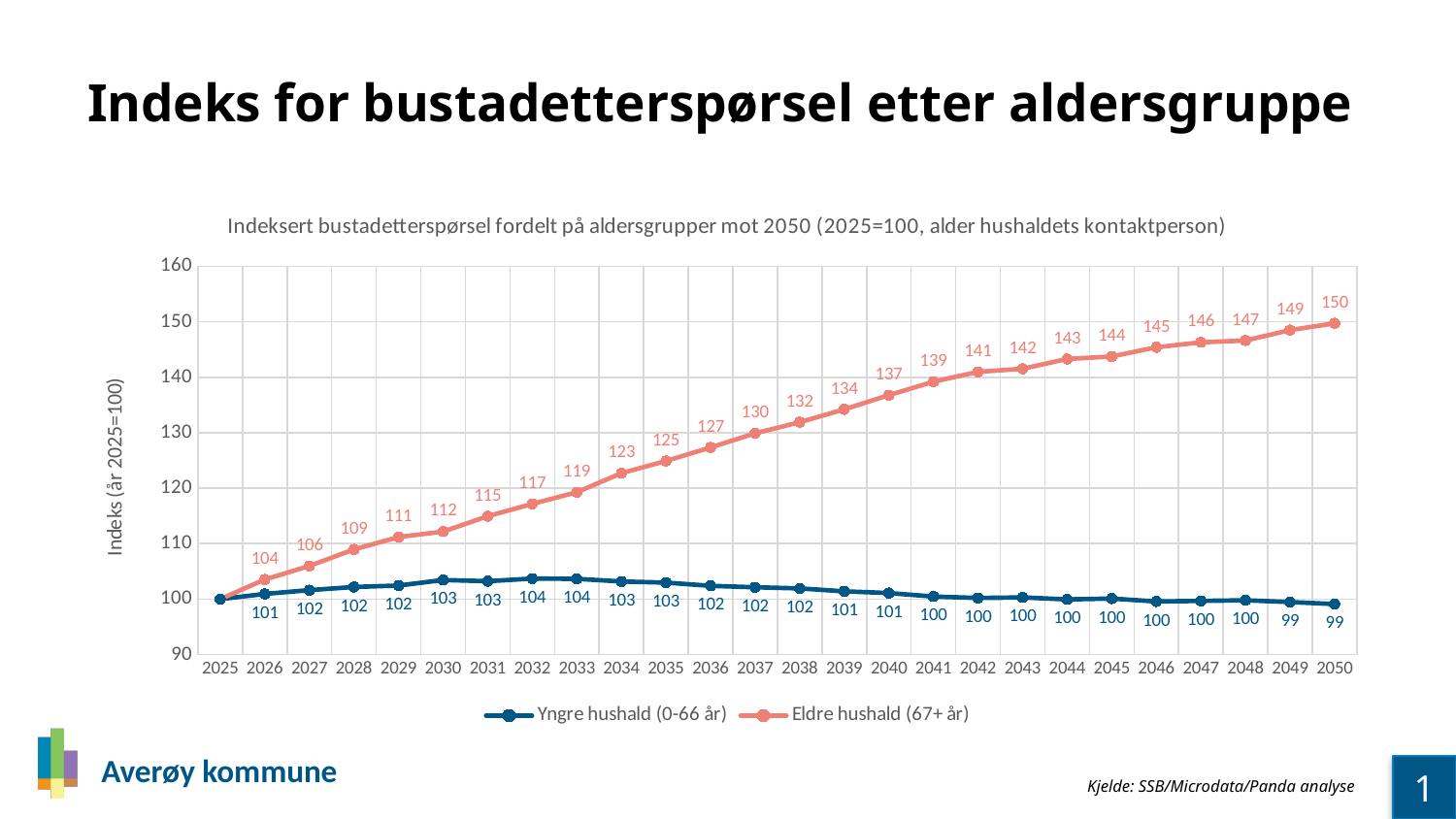
What is the value for Eldre hushald (67+ år) in 2050? 150 What is the value for Eldre hushald (67+ år) in 2040? 137 Does the value for Eldre hushald (67+ år) rise or fall from 2025 to 2050? Rise Which series has the larger value in 2035, Yngre hushald (0-66 år) or Eldre hushald (67+ år)? Eldre hushald (67+ år) What is the label of the y axis? Indeks (år 2025=100) How many years are shown on the x axis? 26 What is the value for Yngre hushald (0-66 år) in 2050? 99 What is the value for Yngre hushald (0-66 år) in 2032? 104 What is the difference between Eldre hushald (67+ år) and Yngre hushald (0-66 år) in 2050? 51 In which year does Eldre hushald (67+ år) reach its highest value? 2050 How many series does the legend list? 2 What kind of chart is shown on the slide? Line chart